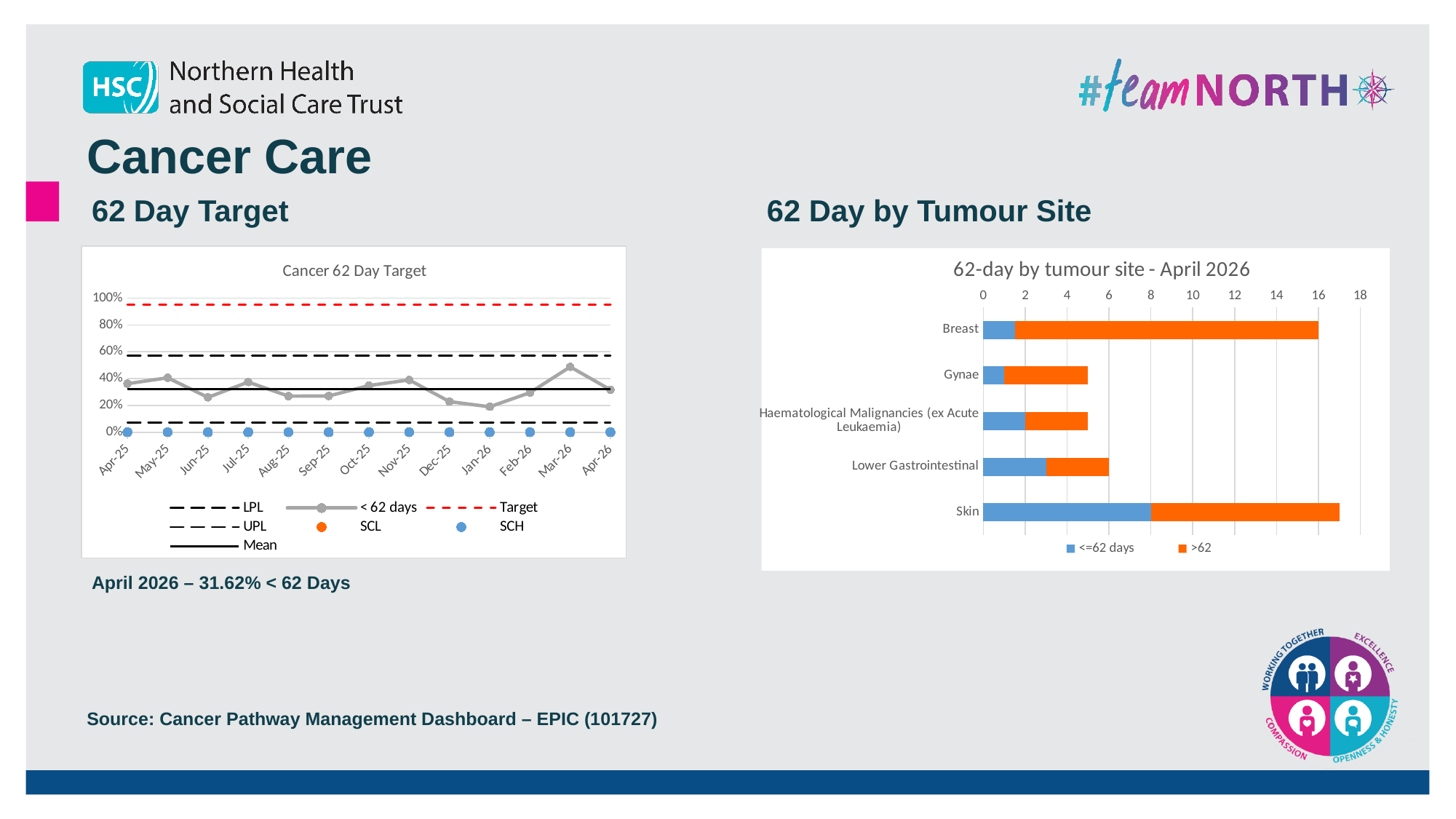
On the Cancer 62 Day Target chart, how many entries does the legend list? 7 On the 62-day by tumour site - April 2026 chart, how many tumour sites are shown? 5 On the 62-day by tumour site - April 2026 chart, is the total bar length for Breast greater or less than 14? greater On the Cancer 62 Day Target chart, which month has the lowest value for the < 62 days line? Jan-26 On the 62-day by tumour site - April 2026 chart, which tumour site has the largest <=62 days segment? Skin On the Cancer 62 Day Target chart, what colour is the Target line? Red What kind of chart is the 62-day by tumour site - April 2026 chart? Bar chart On the Cancer 62 Day Target chart, how many months are plotted along the x axis? 13 On the 62-day by tumour site - April 2026 chart, how many series does the legend list? 2 On the Cancer 62 Day Target chart, which month has the highest value for the < 62 days line? Mar-26 On the Cancer 62 Day Target chart, what percentage of patients were seen within 62 days in April 2026? 31.62%